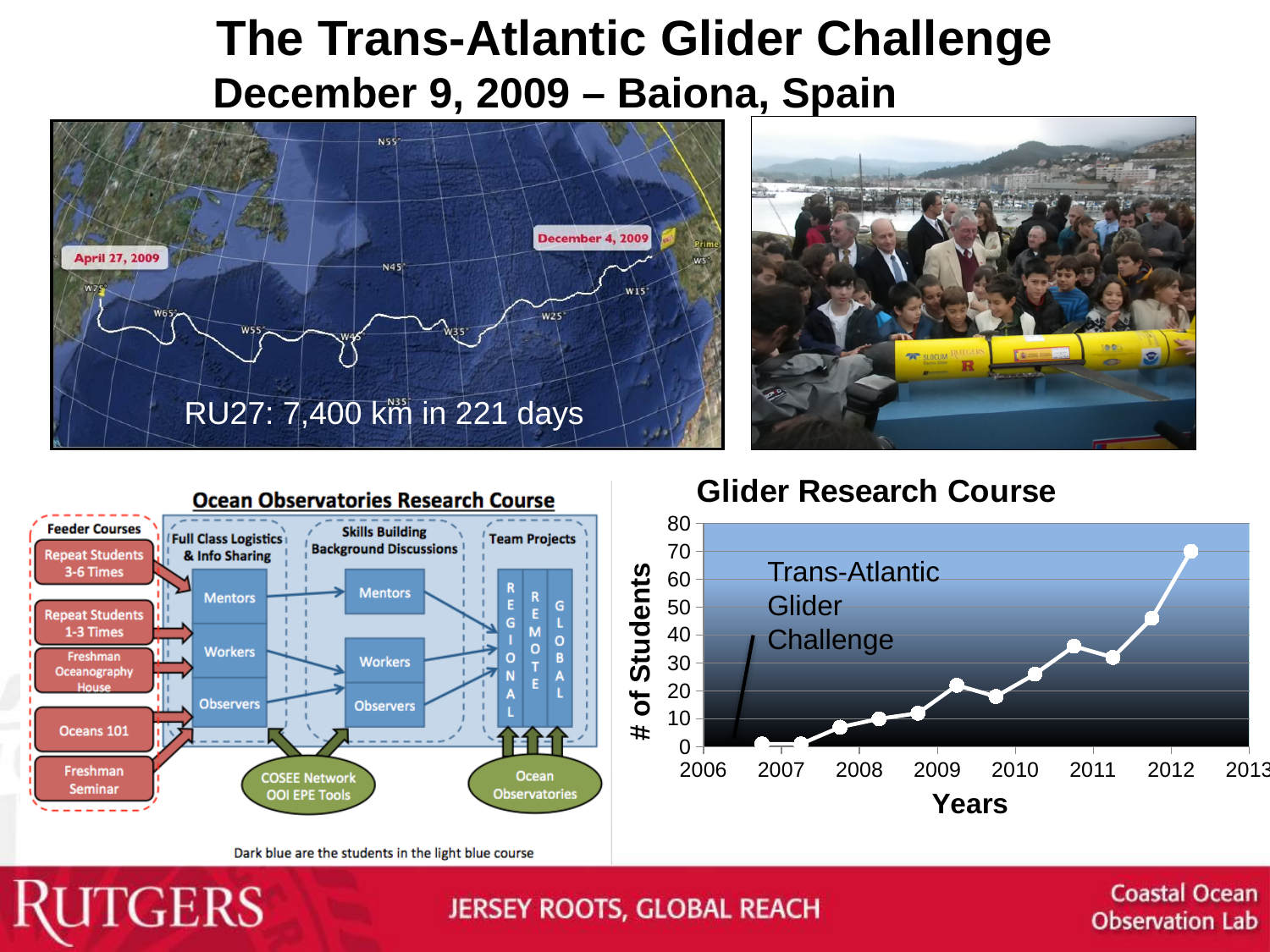
What kind of chart is the "Glider Research Course" chart? line chart In the "Glider Research Course" chart, do the number of students generally rise or fall from 2007 to 2013? rise In the "Glider Research Course" chart, is the value of the first data point near 2007 greater or less than 10? less How many data points are plotted in the "Glider Research Course" chart? 12 What is the title of the chart on the lower right of the slide? Glider Research Course What is the y-axis label of the "Glider Research Course" chart? # of Students In the "Glider Research Course" chart, is the value of the data point just before 2011 greater or less than 30? greater In the "Glider Research Course" chart, in which year range does the highest data point occur? between 2012 and 2013 In the "Glider Research Course" chart, is the value of the last (highest) data point greater or less than 60? greater What is the maximum value shown on the y-axis of the "Glider Research Course" chart? 80 In the "Glider Research Course" chart, which is larger: the value of the point just before 2012 or the value of the point just before 2011? the point just before 2012